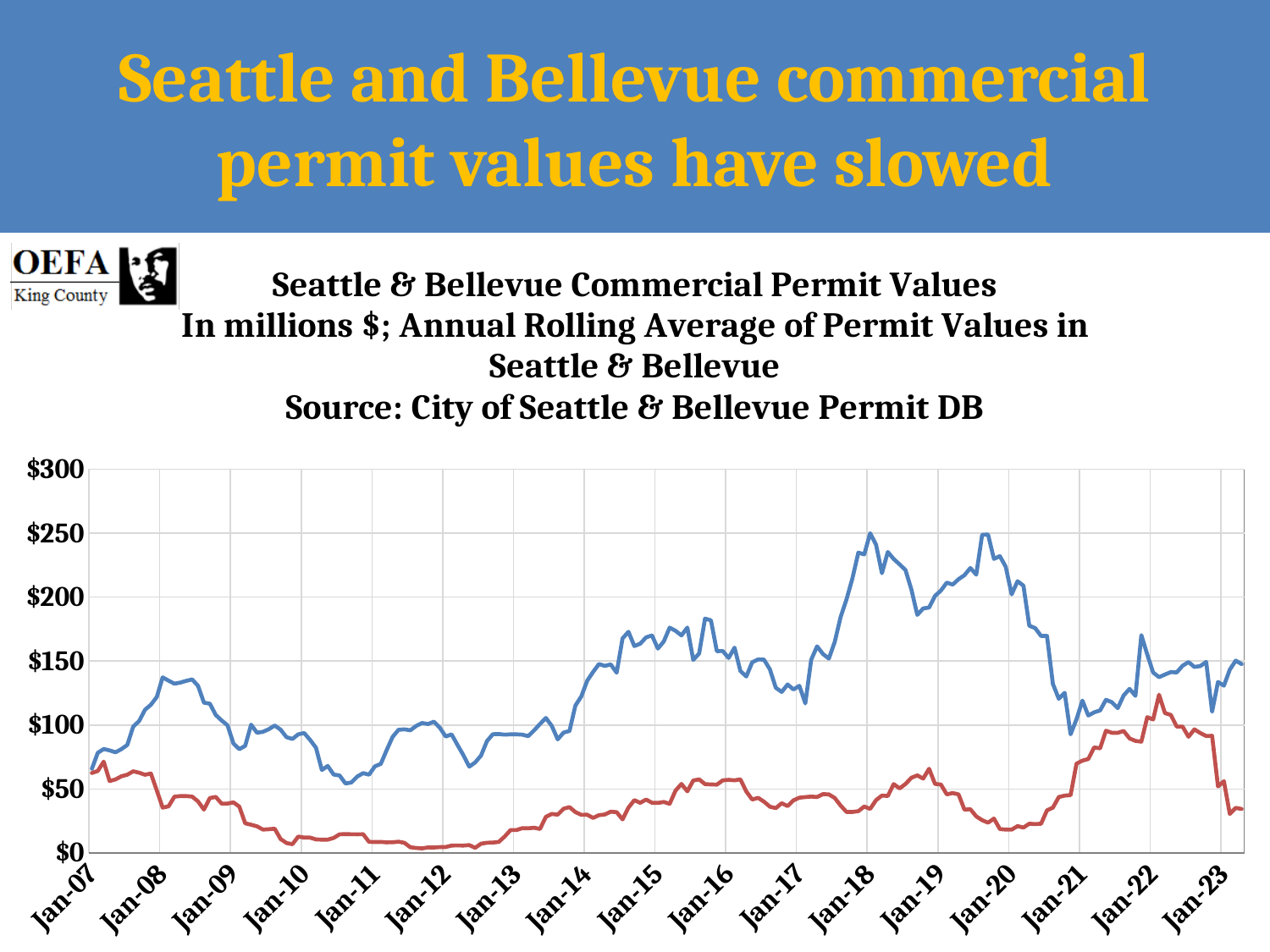
What is the highest value shown on the y axis? $300 Is the value of the blue line at Jan-11 greater or less than $100? less Near which x-axis label does the red line reach its highest value? Jan-22 What kind of chart is shown on the slide? line chart How many lines are plotted on the chart? 2 How many year labels are shown on the x axis? 17 Which line is higher at Jan-18, the blue line or the red line? blue line Is the value of the red line at Jan-12 greater or less than $50? less What is the source cited in the chart title? City of Seattle & Bellevue Permit DB Does the red line rise or fall between Jan-22 and Jan-23? fall Is the value of the red line at Jan-22 greater or less than $50? greater